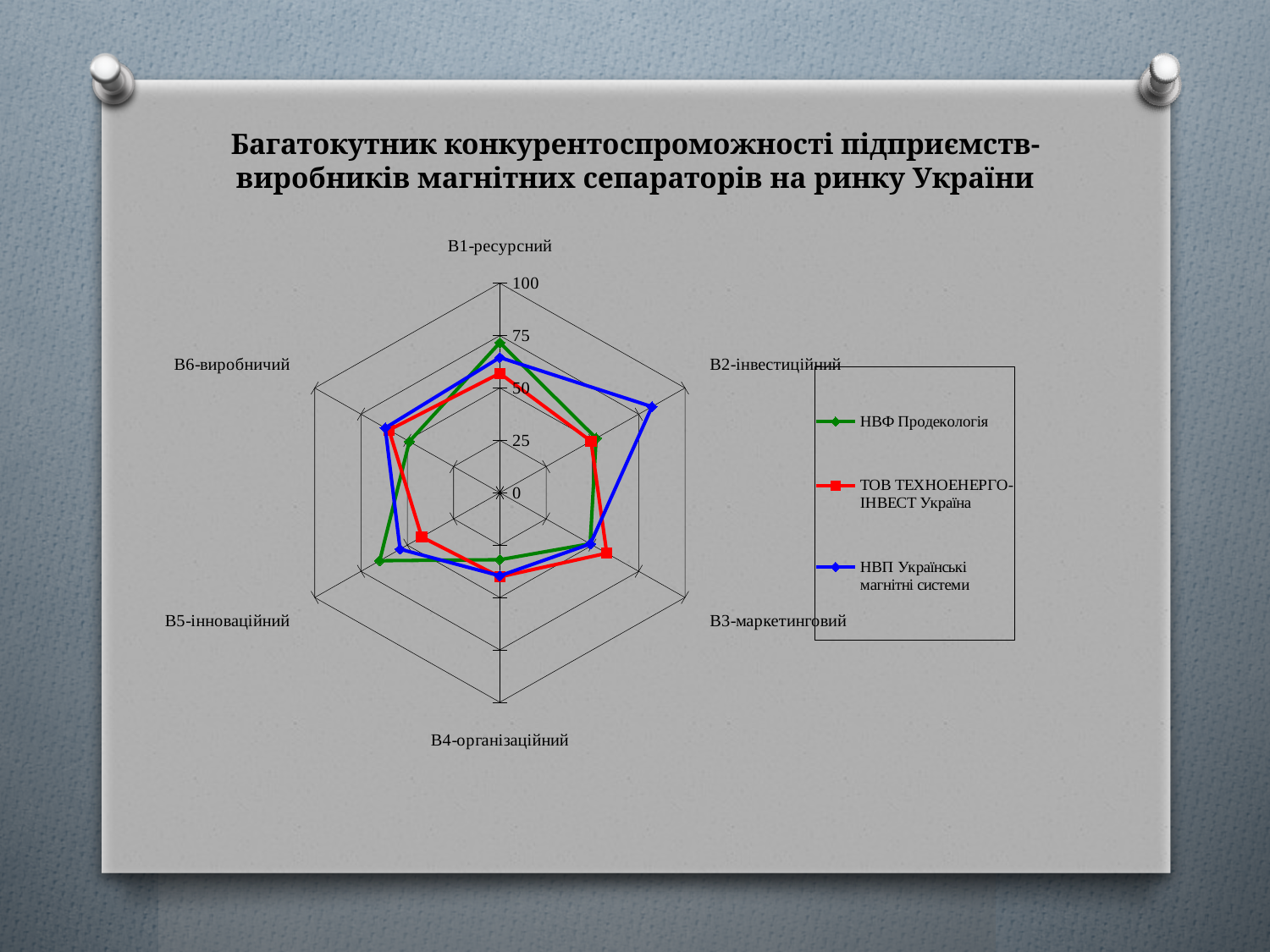
Which series has the highest value on the В2-інвестиційний axis? НВП Українські магнітні системи What colour is used for the series ТОВ ТЕХНОЕНЕРГО-ІНВЕСТ Україна? Red Is the value for НВФ Продекологія on the В1-ресурсний axis greater or less than 50? greater On the В5-інноваційний axis, which series has the larger value: НВФ Продекологія or ТОВ ТЕХНОЕНЕРГО-ІНВЕСТ Україна? НВФ Продекологія Is the value for НВП Українські магнітні системи on the В2-інвестиційний axis greater or less than 75? greater How many axes (categories) does the radar chart have? 6 What kind of chart is shown on the slide? Radar chart Is the value for ТОВ ТЕХНОЕНЕРГО-ІНВЕСТ Україна on the В5-інноваційний axis greater or less than 50? less What is the maximum value shown on the radar chart's axis scale? 100 On the В2-інвестиційний axis, which series has the larger value: НВФ Продекологія or НВП Українські магнітні системи? НВП Українські магнітні системи How many series does the legend list? 3